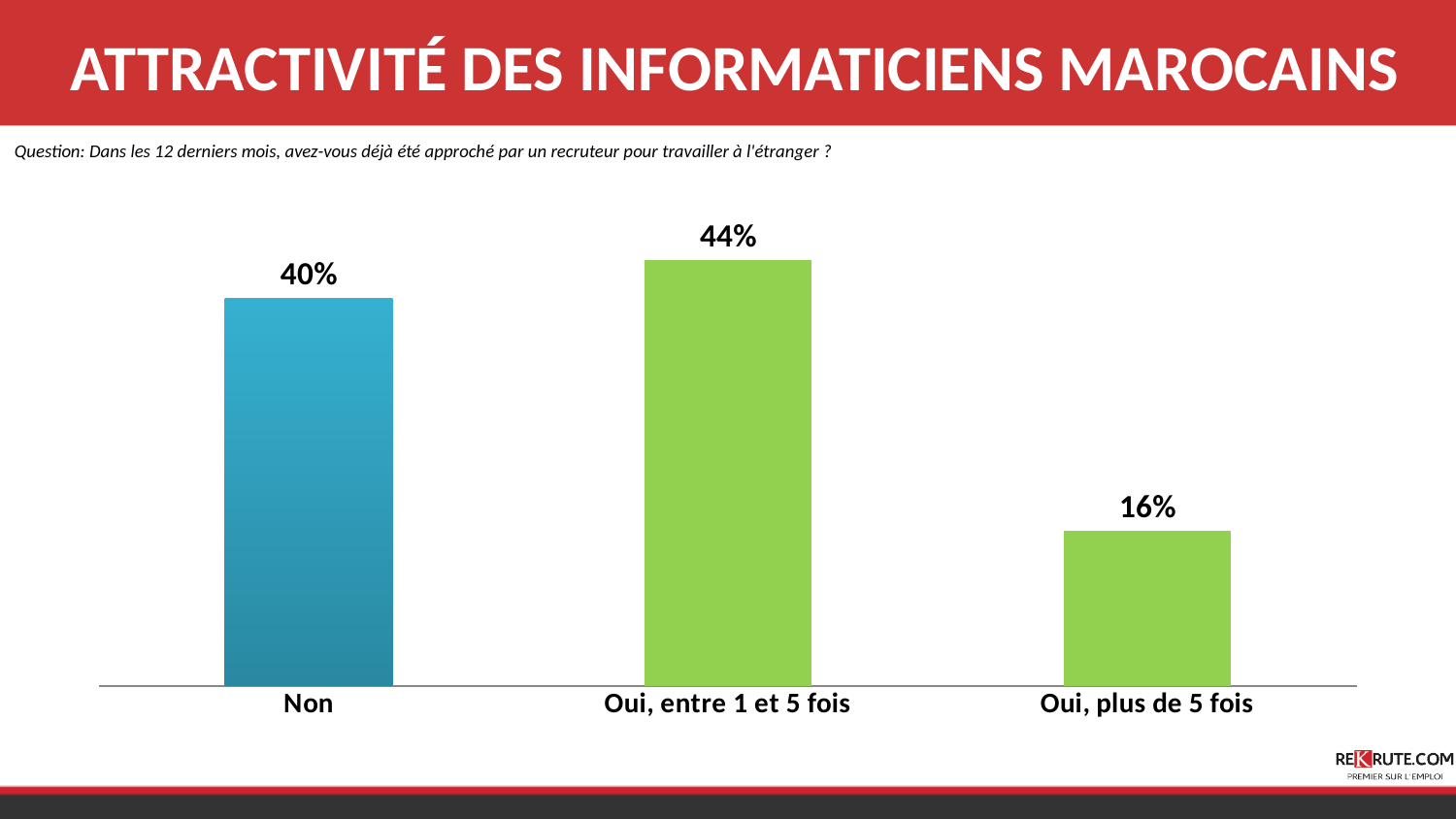
What is the value for "Oui, entre 1 et 5 fois"? 44% How many categories are shown in the chart? 3 What is the value for "Non"? 40% What is the difference between the values for "Non" and "Oui, plus de 5 fois"? 24% What is the difference between the values for "Oui, entre 1 et 5 fois" and "Non"? 4% Which category's bar is coloured blue rather than green? Non What is the combined value of the two "Oui" categories? 60% Which is larger: the value for "Non" or the value for "Oui, plus de 5 fois"? Non Which category has the lowest value? Oui, plus de 5 fois Which category has the highest value? Oui, entre 1 et 5 fois What is the value for "Oui, plus de 5 fois"? 16% What kind of chart is shown on the slide? Bar chart